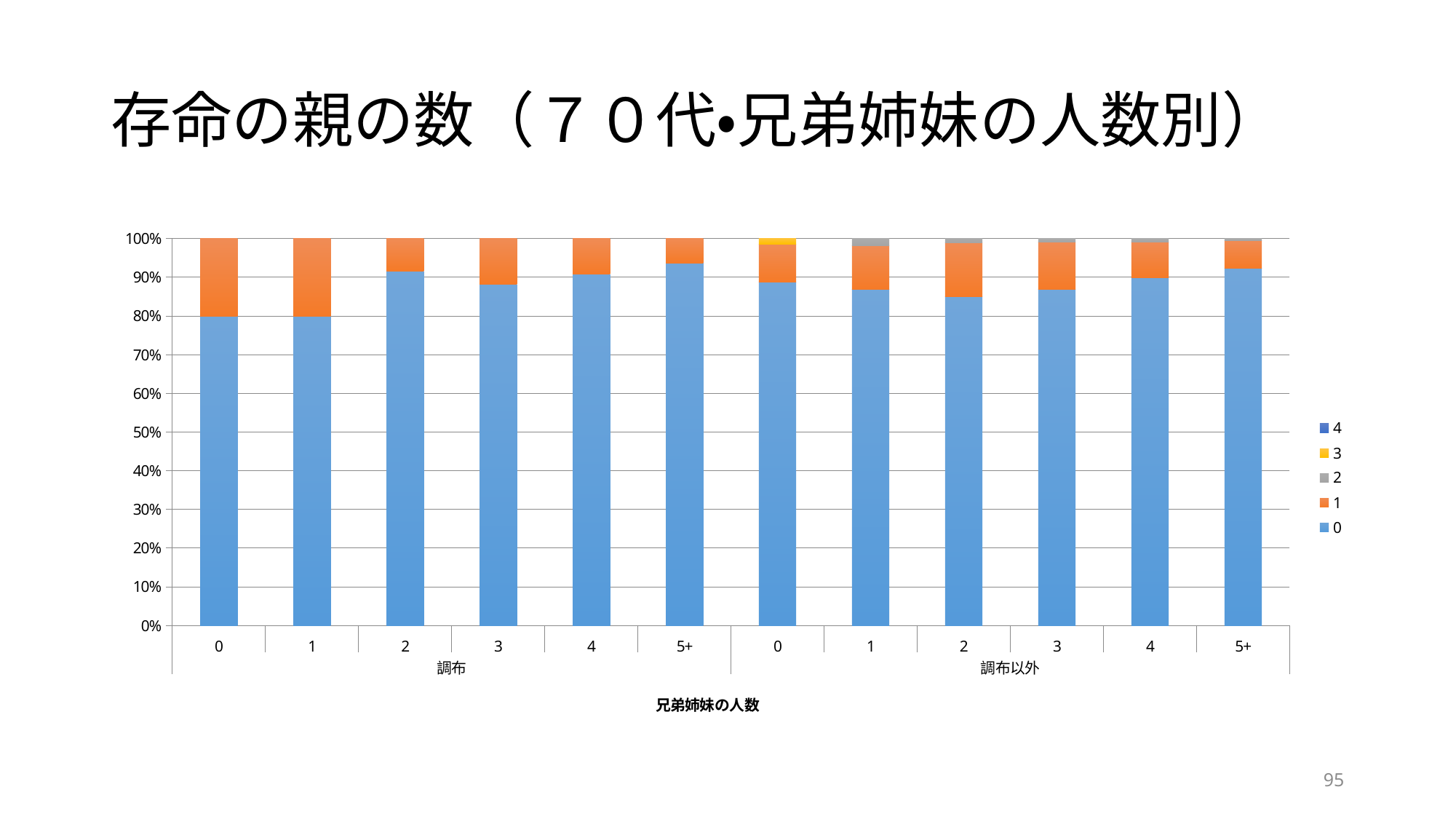
Is the value of series 0 for 調布 3 greater or less than 90%? less Is the value of series 0 for 調布以外 5+ greater or less than 90%? greater What is the total of the stacked bar for 調布 0? 100% What is the title of the chart on the slide? 存命の親の数（７０代•兄弟姉妹の人数別） Is the value of series 0 for 調布 5+ greater or less than 90%? greater Which is larger, the value of series 0 for 調布 5+ or for 調布 0? 調布 5+ How many bars are plotted in the chart? 12 Within the 調布 group, which sibling-count category has the highest value for series 0? 5+ What kind of chart is shown on the slide? stacked bar chart How many series does the legend list? 5 What is the label of the horizontal axis? 兄弟姉妹の人数